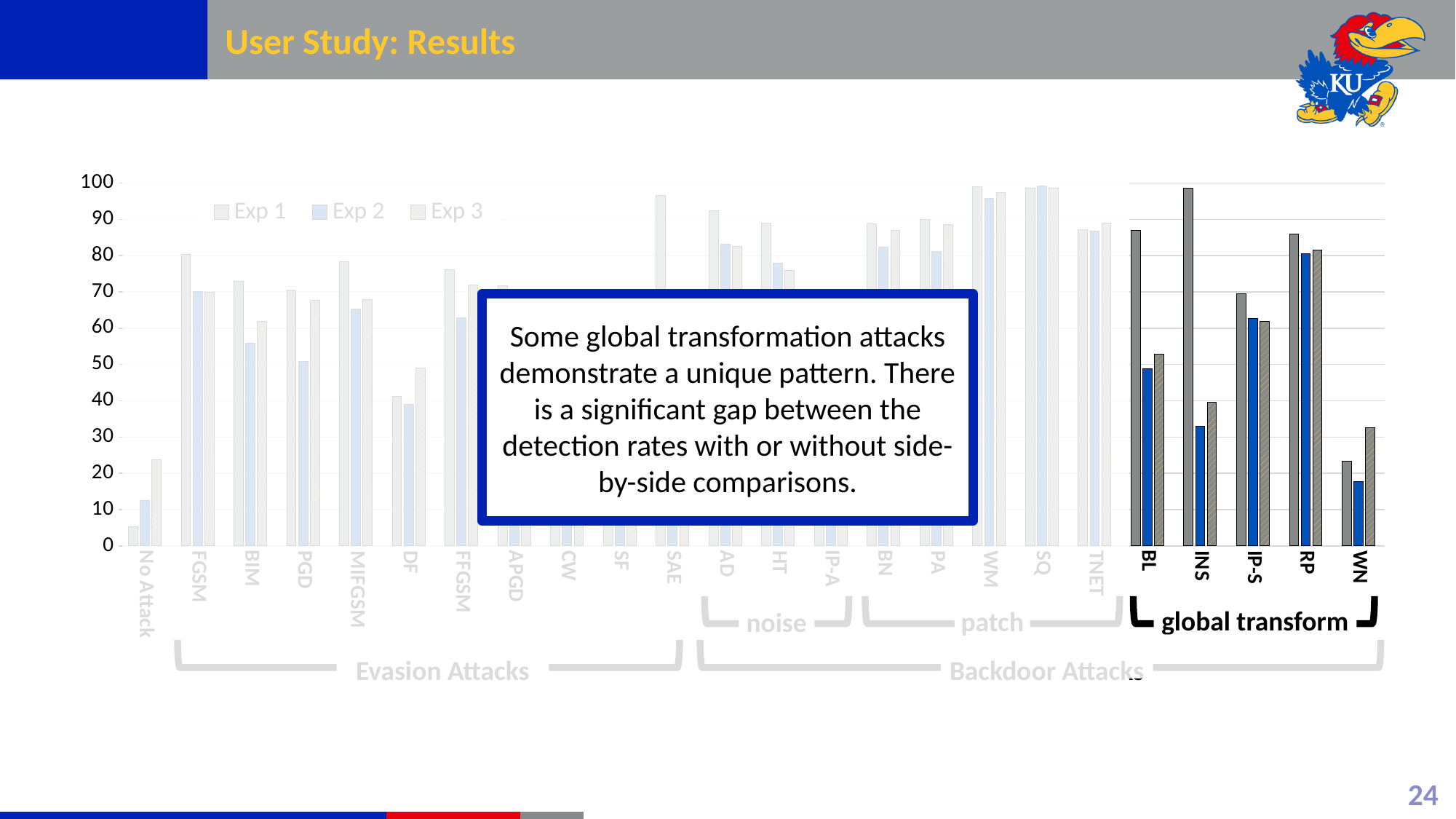
Is the Exp 2 value for INS greater or less than 40? less What are the series names listed in the chart's legend? Exp 1, Exp 2, Exp 3 Among the global transform categories (BL, INS, IP-S, RP, WN), which has the highest Exp 1 value? INS Which is larger: the Exp 2 value for RP or the Exp 2 value for IP-S? RP How many series does the chart's legend list? 3 Is the Exp 3 value for BL greater or less than 60? less Among the global transform categories (BL, INS, IP-S, RP, WN), which has the lowest Exp 1 value? WN How many categories are in the 'global transform' group of the chart? 5 For BL, which is larger: the Exp 1 value or the Exp 2 value? Exp 1 Is the Exp 1 value for INS greater or less than 90? greater What kind of chart is shown on the slide? bar chart